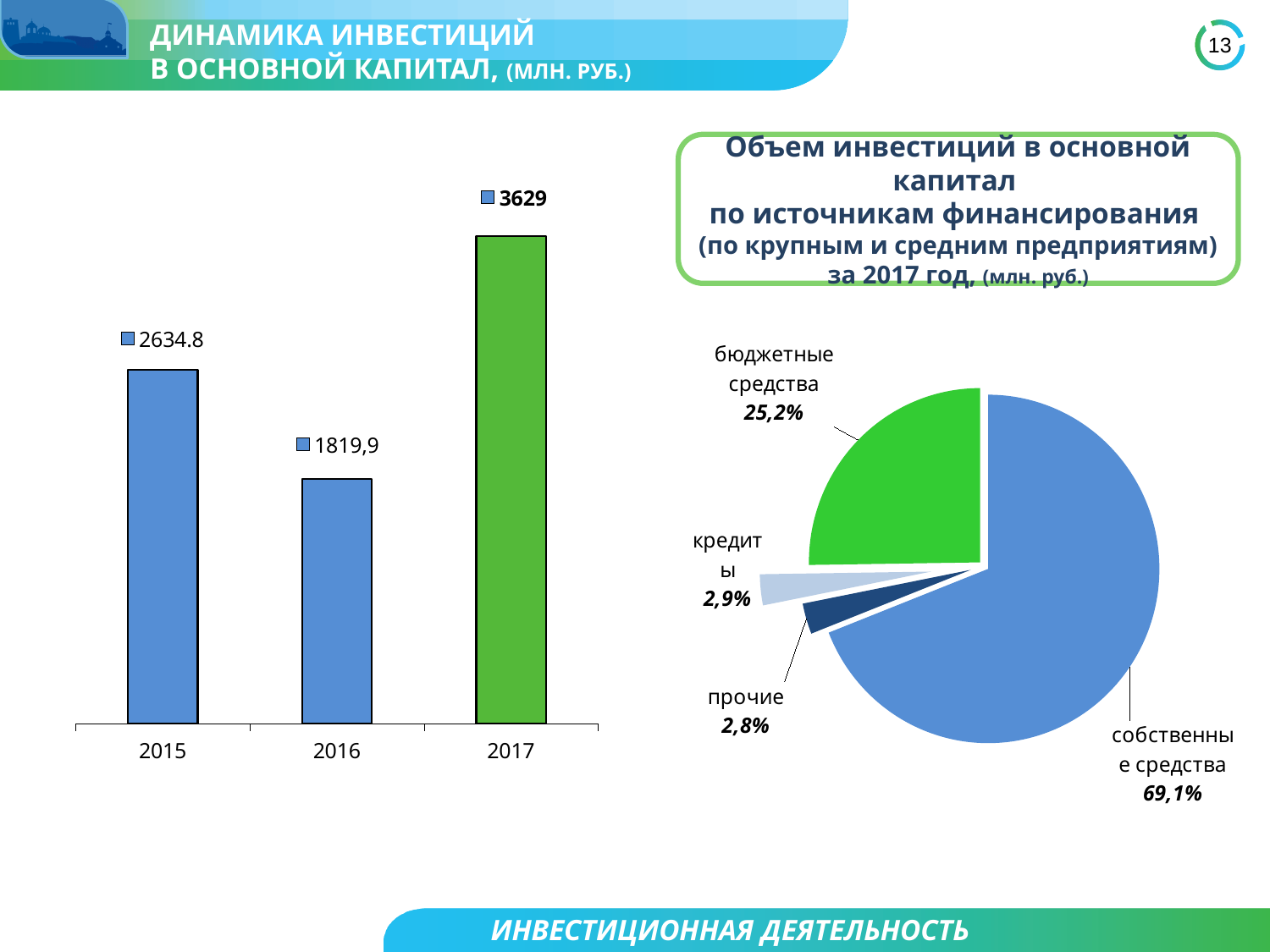
In the bar chart on the left, what is the difference between the values for 2017 and 2015? 994.2 In the bar chart on the left, which is larger, the value for 2015 or the value for 2016? 2015 In the bar chart on the left, did the value rise or fall from 2016 to 2017? rise In the bar chart on the left, which year has the highest value? 2017 In the bar chart on the left, which year has the lowest value? 2016 In the bar chart on the left, what is the value for 2017? 3629 In the pie chart on the right, what share is labelled for собственные средства? 69,1% In the bar chart on the left, how many years are shown? 3 In the pie chart on the right, what share is labelled for бюджетные средства? 25,2% In the bar chart on the left, what is the value for 2015? 2634.8 In the pie chart on the right, how many slices are there? 4 In the bar chart on the left, what is the value for 2016? 1819,9